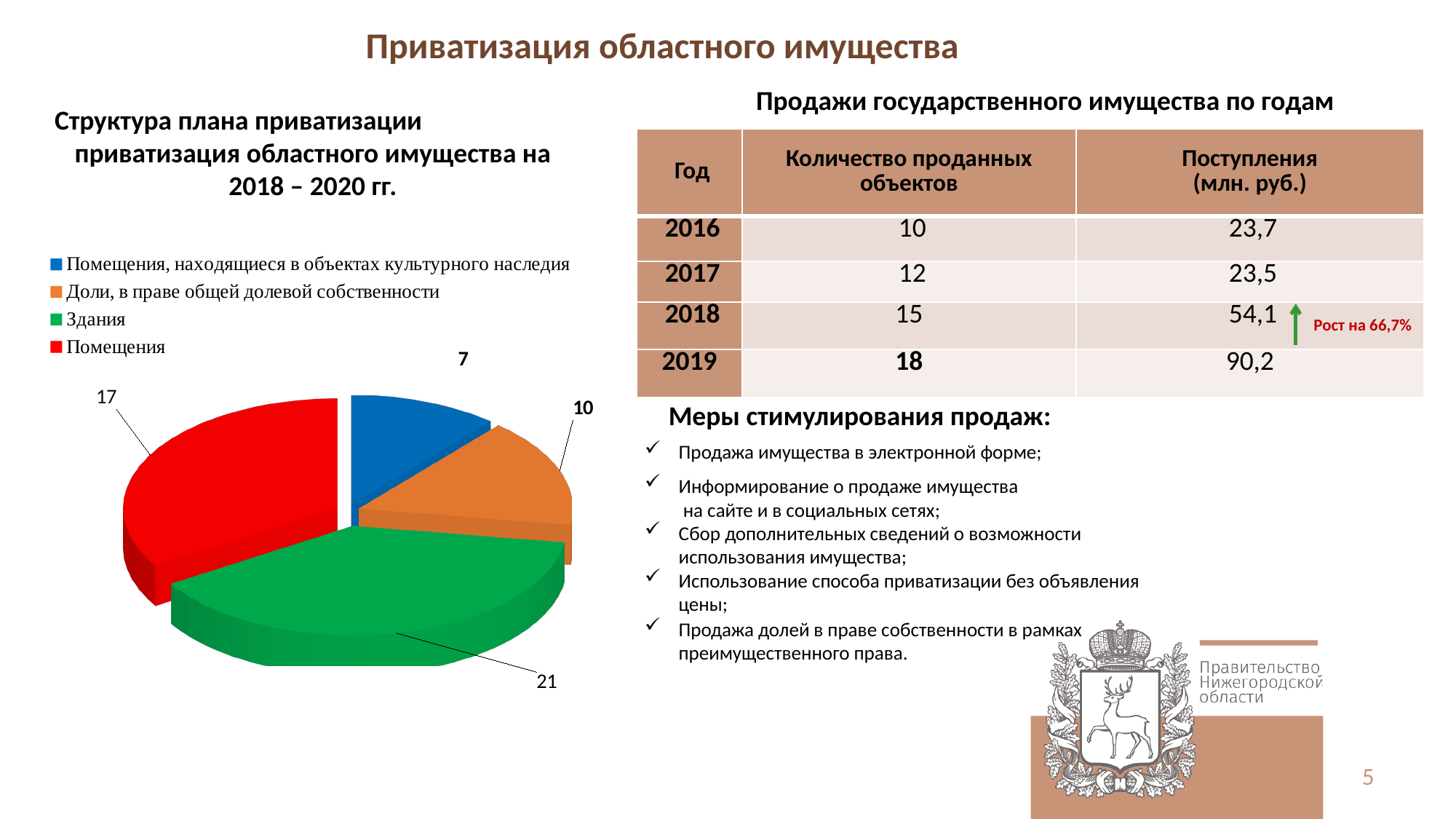
Which category has the smallest slice in the pie chart? Помещения, находящиеся в объектах культурного наследия What colour is the Здания slice in the pie chart? Green What is the difference between the values for Здания and Помещения in the pie chart? 4 What is the value for Помещения, находящиеся в объектах культурного наследия in the pie chart? 7 Which is larger in the pie chart: Доли, в праве общей долевой собственности or Помещения? Помещения What is the value for Помещения in the pie chart? 17 What is the value for Доли, в праве общей долевой собственности in the pie chart? 10 What is the total of all slices in the pie chart? 55 What is the value for Здания in the pie chart? 21 Which category has the largest slice in the pie chart? Здания How many categories does the pie chart have? 4 What type of chart is shown on the slide? Pie chart